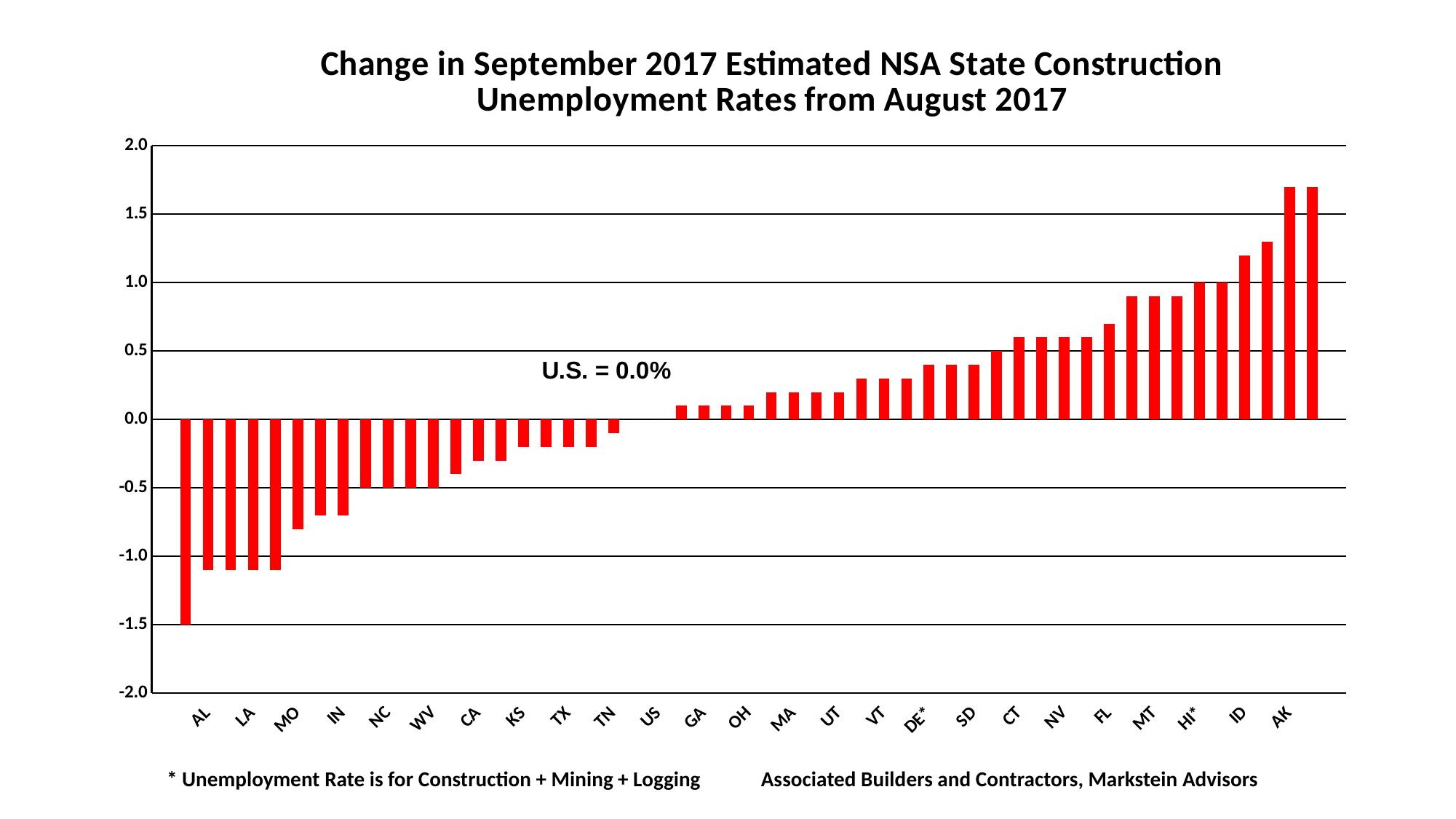
Is the value for AK greater or less than 1.5? greater Do the bar values rise or fall moving from left to right along the x axis? Rise What kind of chart is shown on the slide? Bar chart Is the value for GA greater or less than 0.5? less Is the value for MO greater or less than -0.5? less What is the title of the chart? Change in September 2017 Estimated NSA State Construction Unemployment Rates from August 2017 How many category labels are printed along the x axis? 25 Which has the larger value, ID or MO? ID Which has the larger value, AK or AL? AK What value is printed for the U.S. on the chart? 0.0%